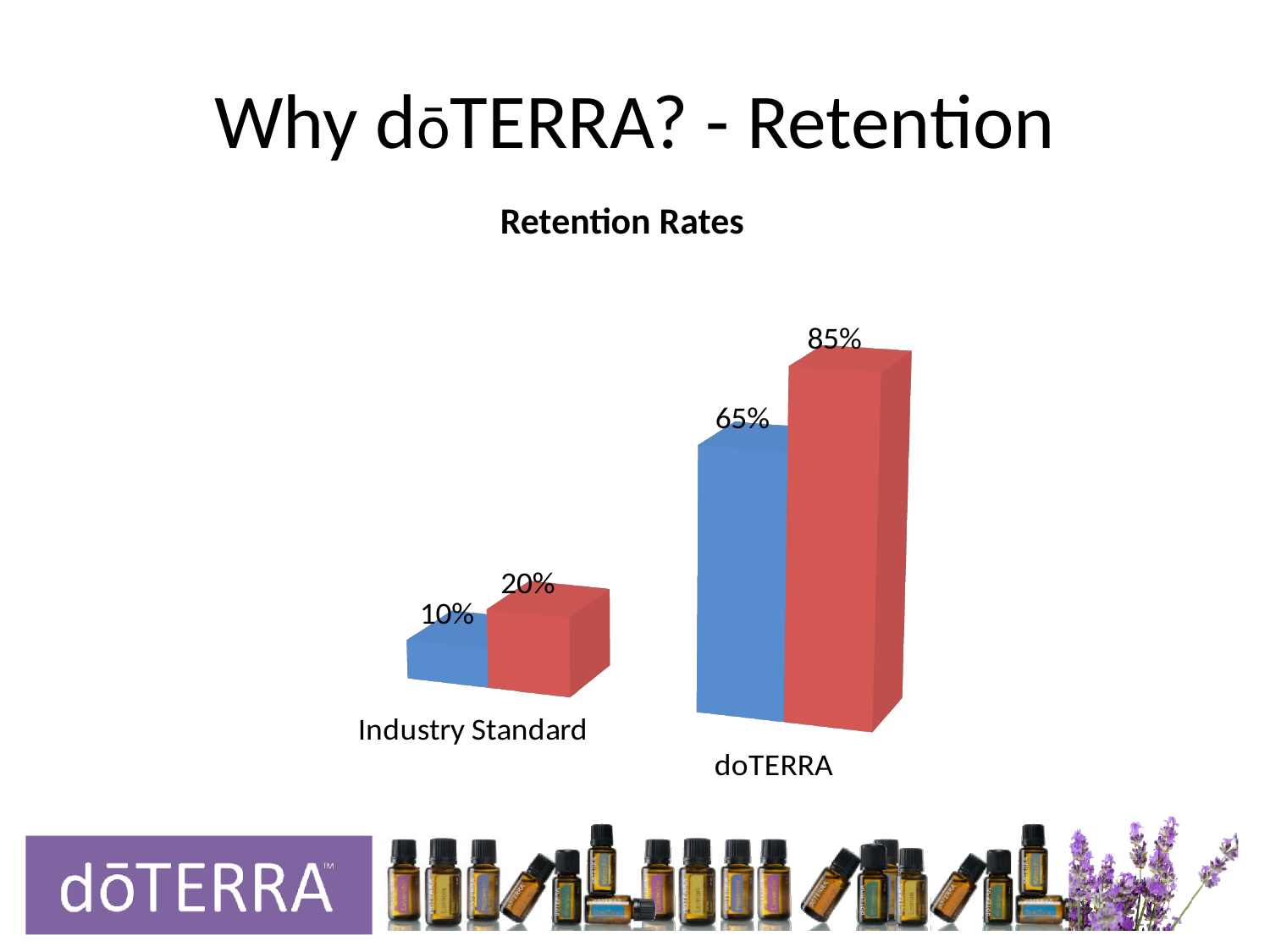
What is the value of the red bar for Industry Standard? 20% What is the value of the blue bar for doTERRA? 65% What is the difference between the blue bar for doTERRA and the blue bar for Industry Standard? 55% What is the difference between the red bar for doTERRA and the red bar for Industry Standard? 65% What is the value of the red bar for doTERRA? 85% How many categories are shown on the x axis of the chart? 2 What is the title of the chart? Retention Rates Which bar in the chart has the highest value? the red bar for doTERRA (85%) Which is larger, the blue bar for doTERRA or the red bar for Industry Standard? the blue bar for doTERRA What is the value of the blue bar for Industry Standard? 10% Which bar in the chart has the lowest value? the blue bar for Industry Standard (10%) What type of chart is shown on the slide? bar chart